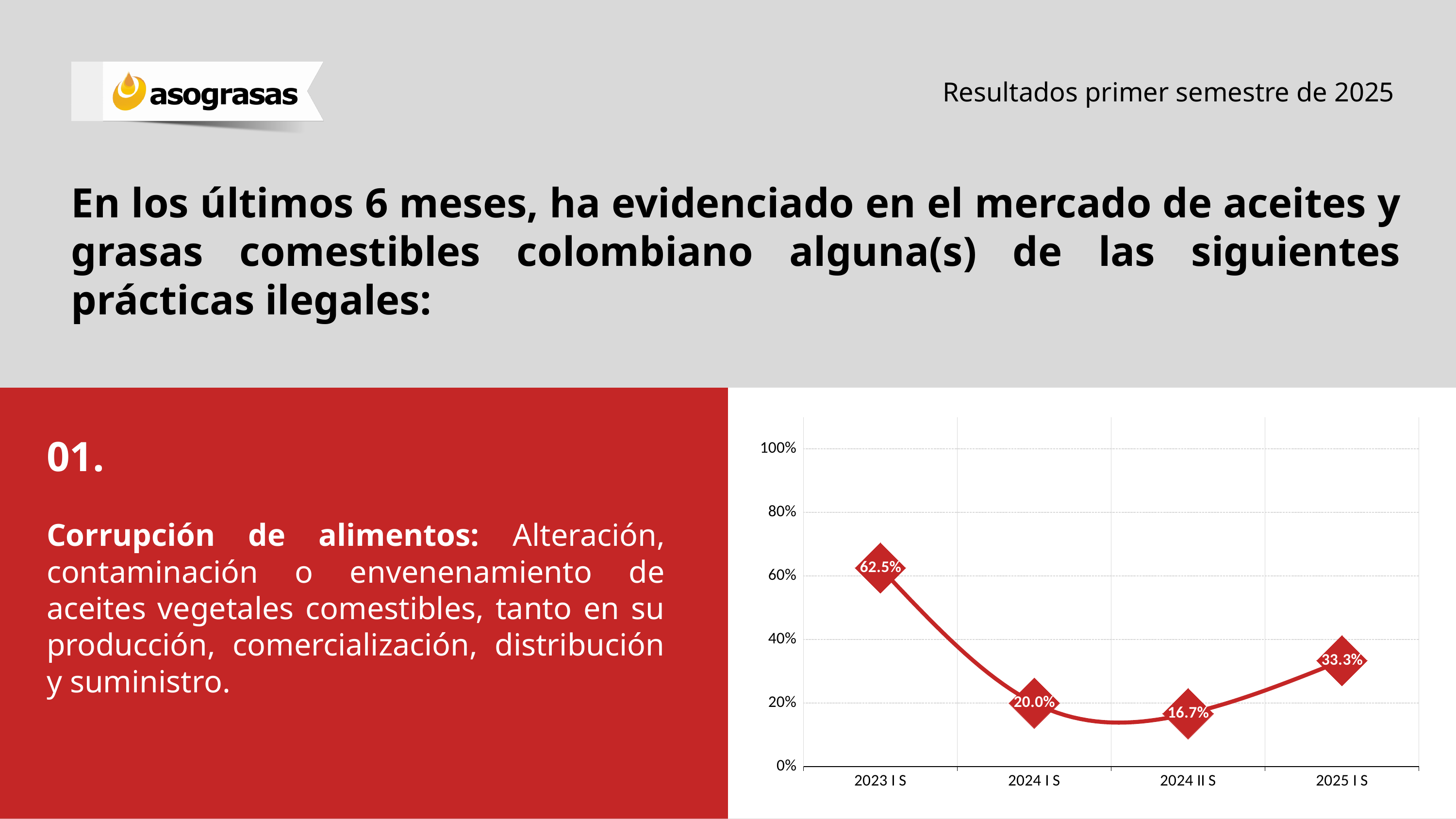
What is the value for 2024 II S? 16.7% Does the value rise or fall from 2024 II S to 2025 I S? rise Which is larger, the value for 2024 I S or the value for 2025 I S? 2025 I S How many periods are plotted on the chart? 4 What kind of chart is shown on the slide? line chart Which period has the lowest value? 2024 II S Which period has the highest value? 2023 I S What is the value for 2024 I S? 20.0% What is the value for 2025 I S? 33.3% What is the difference between the values for 2023 I S and 2025 I S? 29.2% What is the value for 2023 I S? 62.5% Is the value for 2023 I S greater or less than 60%? greater